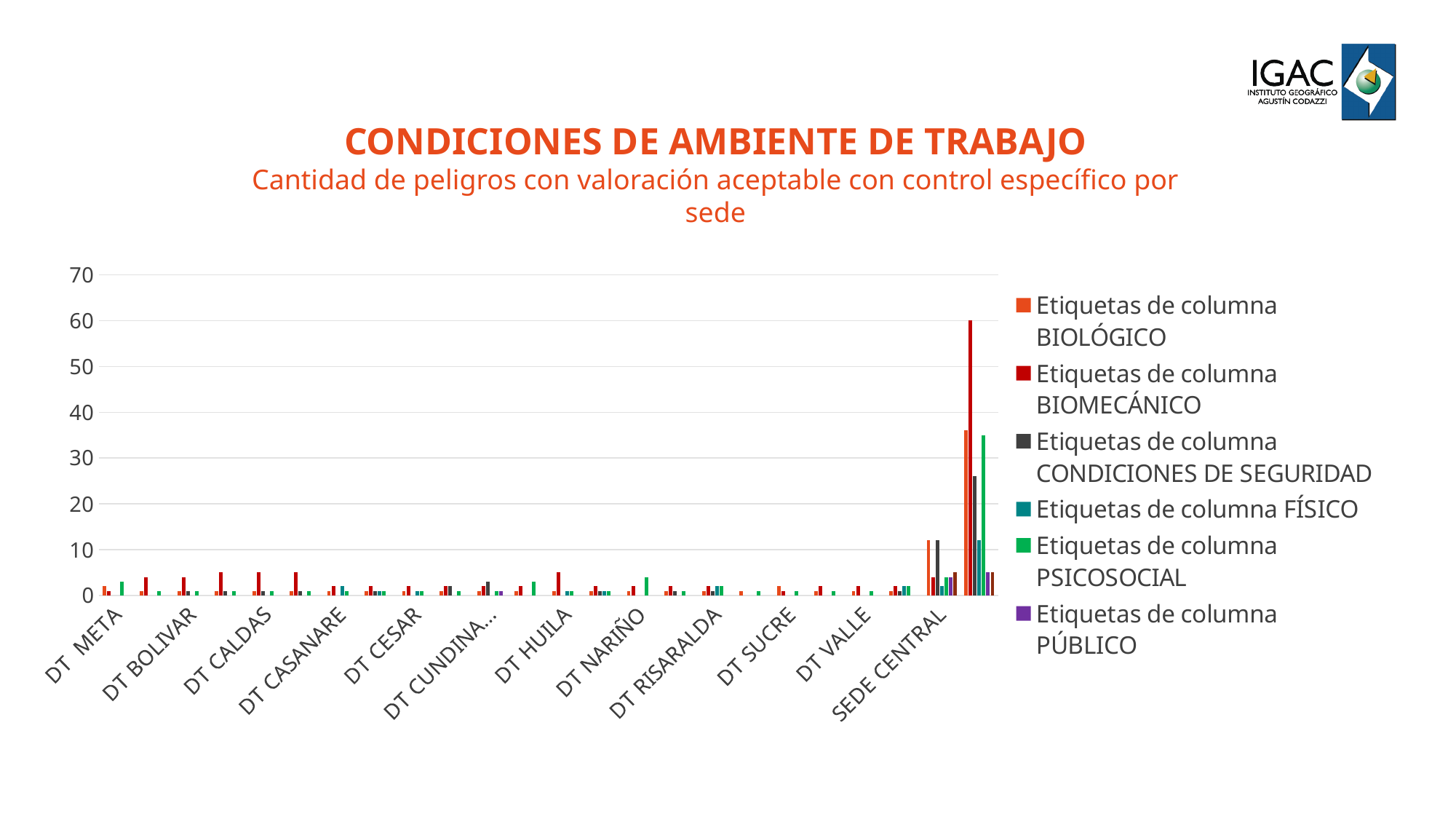
At DT NARIÑO, which is larger: PSICOSOCIAL or BIOLÓGICO? PSICOSOCIAL How many series does the legend list? 6 What is the highest value shown on the vertical axis? 70 What kind of chart is shown on the slide? bar chart Which colour represents the series 'Etiquetas de columna PSICOSOCIAL' in the legend? green Is the value for BIOLÓGICO at DT META greater or less than 10? less Is the tallest bar on the chart greater or less than 50? greater Which series has the tallest bar on the chart? BIOMECÁNICO Is the value for BIOLÓGICO at SEDE CENTRAL greater or less than 10? greater At DT CALDAS, which is larger: BIOMECÁNICO or BIOLÓGICO? BIOMECÁNICO What is the main title of the chart? CONDICIONES DE AMBIENTE DE TRABAJO